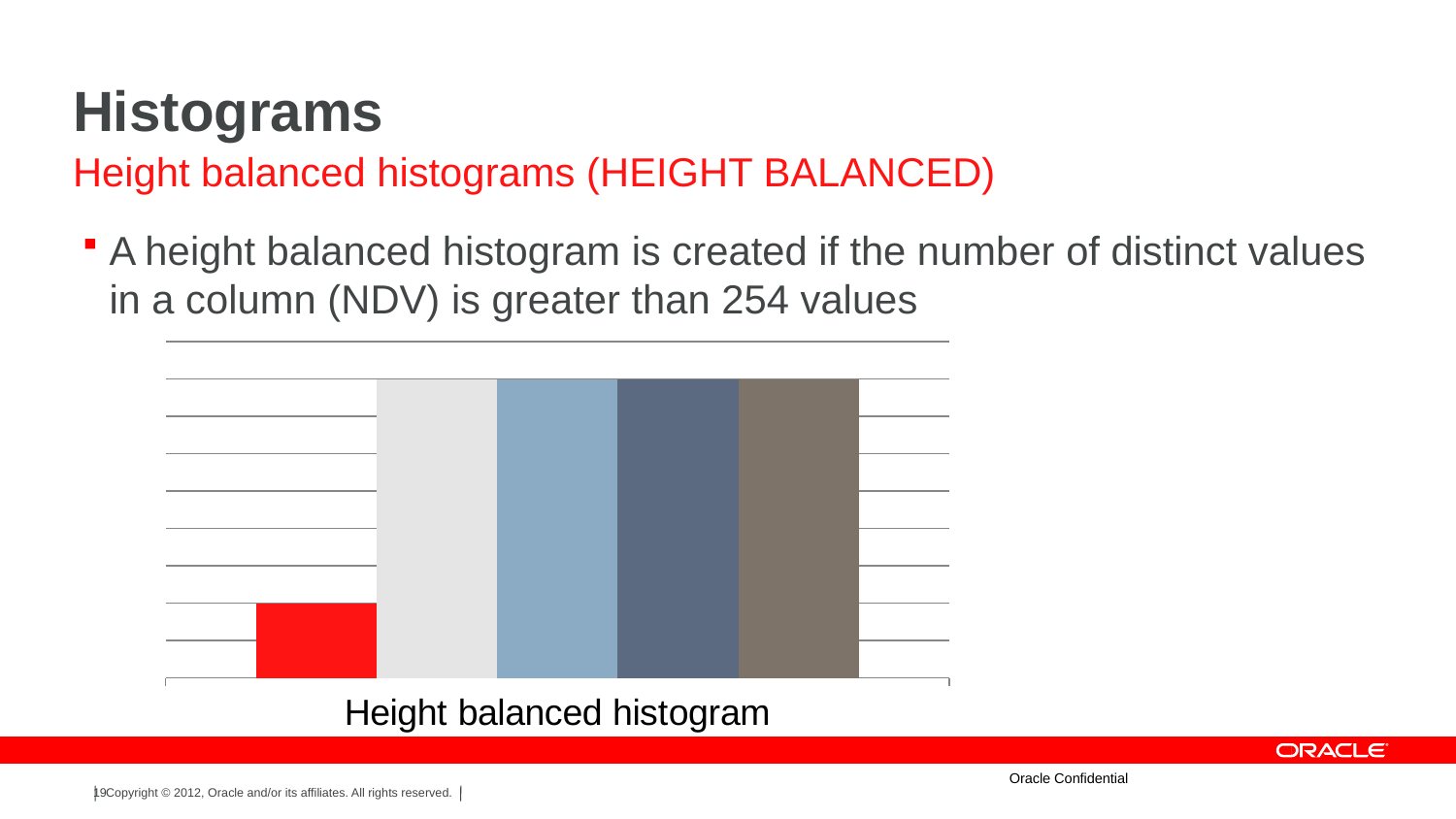
Do the four bars to the right of the red bar appear to have the same height? yes What is the title shown beneath the chart? Height balanced histogram What kind of chart is shown on the slide? bar chart How many bars are plotted in the chart? 5 What colour is the first (leftmost) bar in the chart? red Is the red bar taller or shorter than the light grey bar next to it? shorter Which bar is the shortest in the chart? the red bar (first from the left)